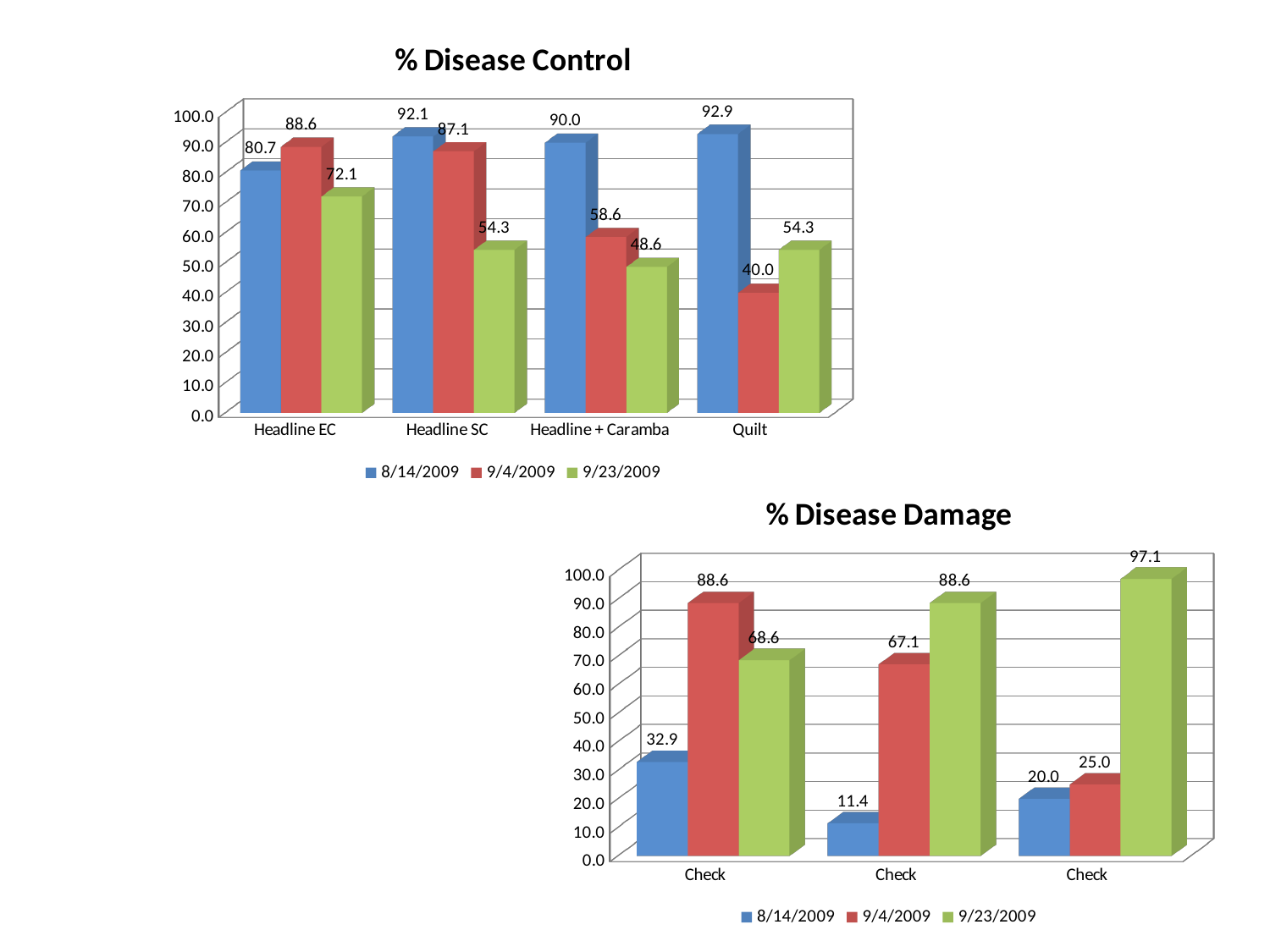
In the % Disease Control chart, what is the value for Quilt in the 9/4/2009 series? 40.0 In the % Disease Control chart, what is the value for Headline EC in the 9/23/2009 series? 72.1 How many categories are shown on the x axis of the % Disease Control chart? 4 In the % Disease Damage chart, what is the difference between the 9/4/2009 and 8/14/2009 values in the second (middle) Check group? 55.7 In the % Disease Control chart, which is larger for Headline EC: the 8/14/2009 value or the 9/4/2009 value? 9/4/2009 What kind of chart is the % Disease Damage chart? Bar chart In the % Disease Damage chart, what is the 9/23/2009 value for the third (rightmost) Check group? 97.1 In the % Disease Damage chart, do the 9/23/2009 values rise or fall from the first Check group to the third? Rise In the % Disease Control chart, what is the difference between the 8/14/2009 and 9/23/2009 values for Headline SC? 37.8 In the % Disease Control chart, which category has the highest value in the 8/14/2009 series? Quilt In the % Disease Control chart, which category has the lowest value in the 9/23/2009 series? Headline + Caramba How many series does the legend of the % Disease Damage chart list? 3